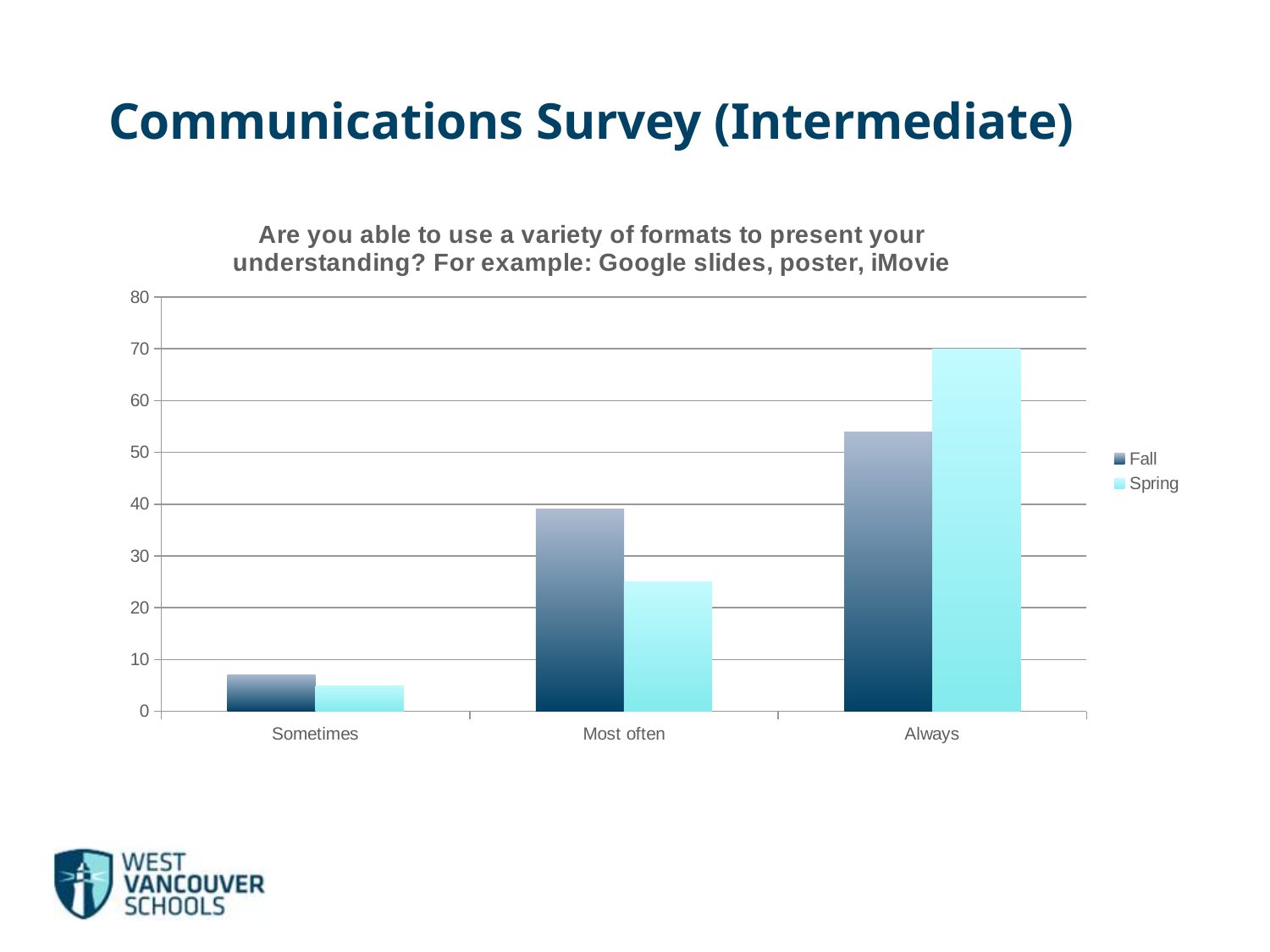
How many series does the legend list? 2 Is the Fall value for Most often greater or less than 30? greater How many categories are shown on the x axis? 3 Is the Fall value for Always greater or less than 50? greater For Always, which series has the larger value, Fall or Spring? Spring Which category has the highest Spring value? Always For Most often, which series has the larger value, Fall or Spring? Fall Do the Spring values rise or fall moving from Sometimes to Always along the x axis? rise What are the two series named in the legend? Fall and Spring Is the Spring value for Sometimes greater or less than 10? less Which category has the lowest Fall value? Sometimes What kind of chart is shown on the slide? bar chart